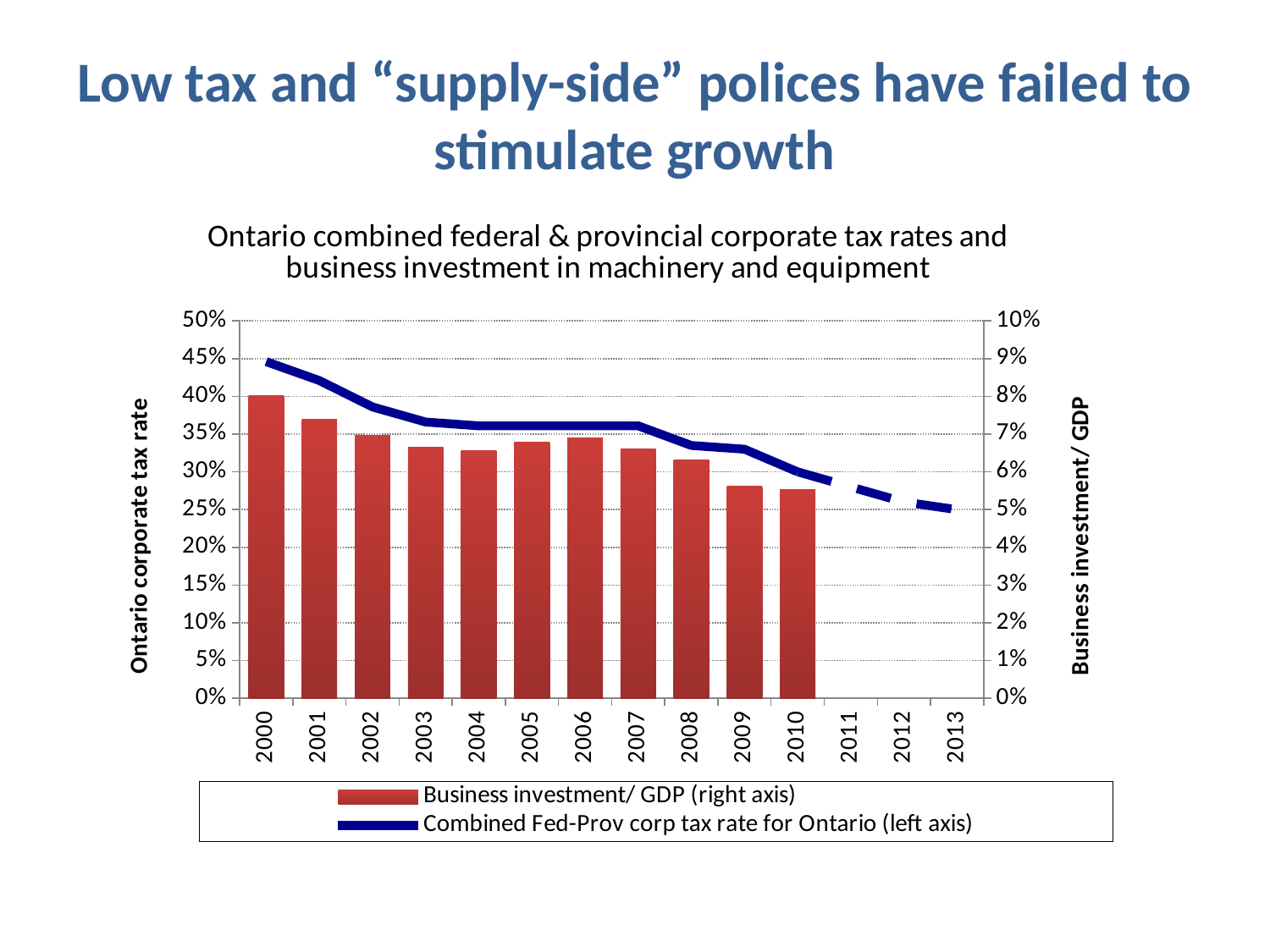
Is the Combined Fed-Prov corp tax rate for Ontario in 2000 greater or less than 40%? greater Is the Combined Fed-Prov corp tax rate for Ontario in 2013 greater or less than 30%? less Is the Business investment/ GDP value for 2000 greater or less than 7%? greater What is the title of the chart? Ontario combined federal & provincial corporate tax rates and business investment in machinery and equipment Which year has the highest bar for Business investment/ GDP? 2000 Which year has the larger Business investment/ GDP bar, 2000 or 2010? 2000 What kind of chart is shown on the slide? A combination bar and line chart Does the Combined Fed-Prov corp tax rate for Ontario rise or fall from 2000 to 2013? fall How many series does the legend list? 2 What is the label of the right-hand vertical axis? Business investment/ GDP How many years have a bar for Business investment/ GDP? 11